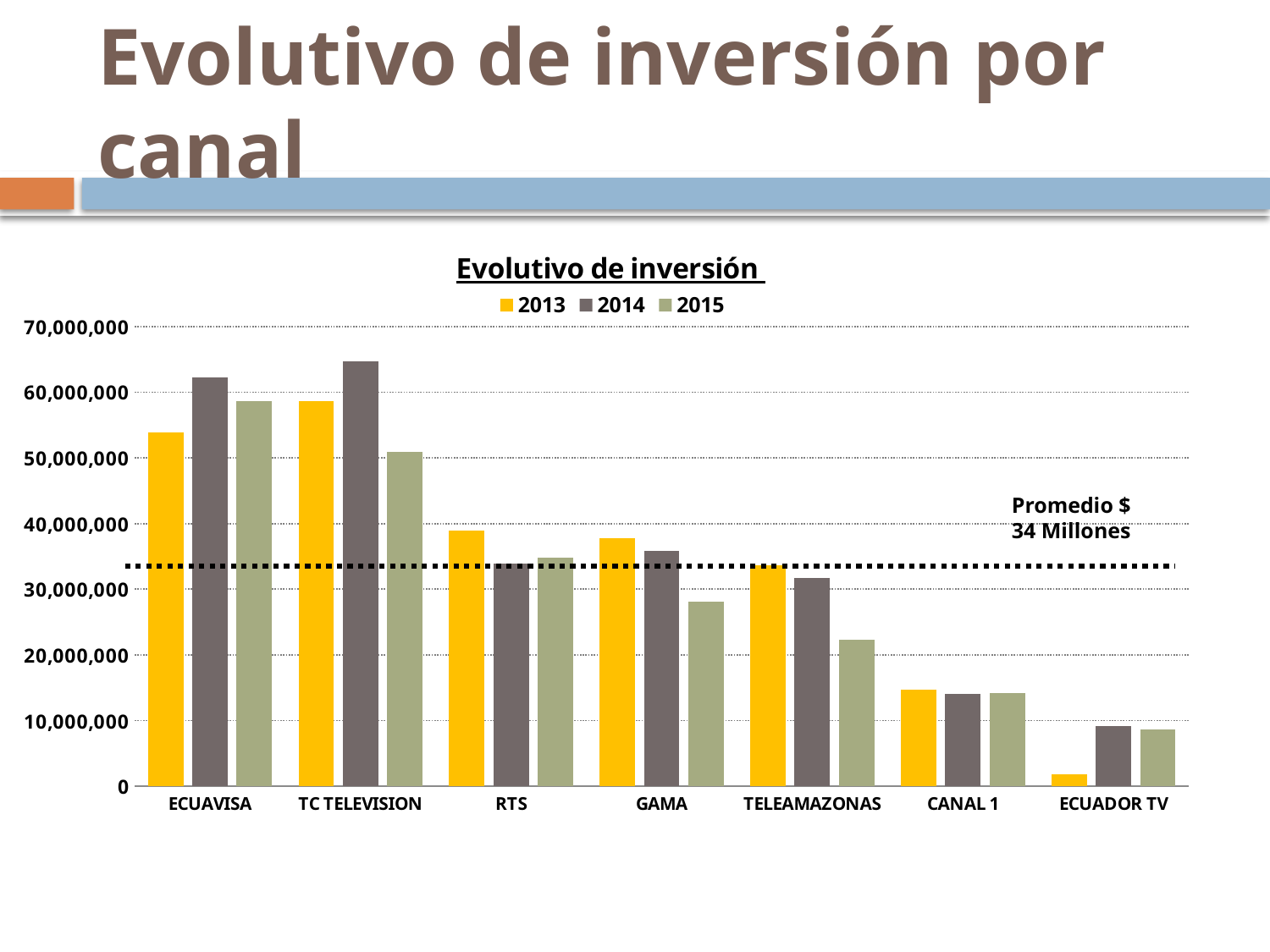
Which channel has the lowest value for 2013? ECUADOR TV Which is larger, the 2013 value for GAMA or the 2013 value for TELEAMAZONAS? GAMA Do the values for TELEAMAZONAS rise or fall from 2013 to 2015? fall Is the 2013 value for ECUAVISA greater or less than 50,000,000? greater Is the 2015 value for TELEAMAZONAS greater or less than 30,000,000? less What are the entries in the chart's legend? 2013, 2014, 2015 What does the label next to the dotted horizontal line on the chart say? Promedio $ 34 Millones Which channel has the highest value for 2014? TC TELEVISION How many series does the legend of the chart list? 3 How many channels are shown on the x axis of the chart? 7 Is the 2013 value for CANAL 1 greater or less than 10,000,000? greater What kind of chart is shown on the slide? bar chart